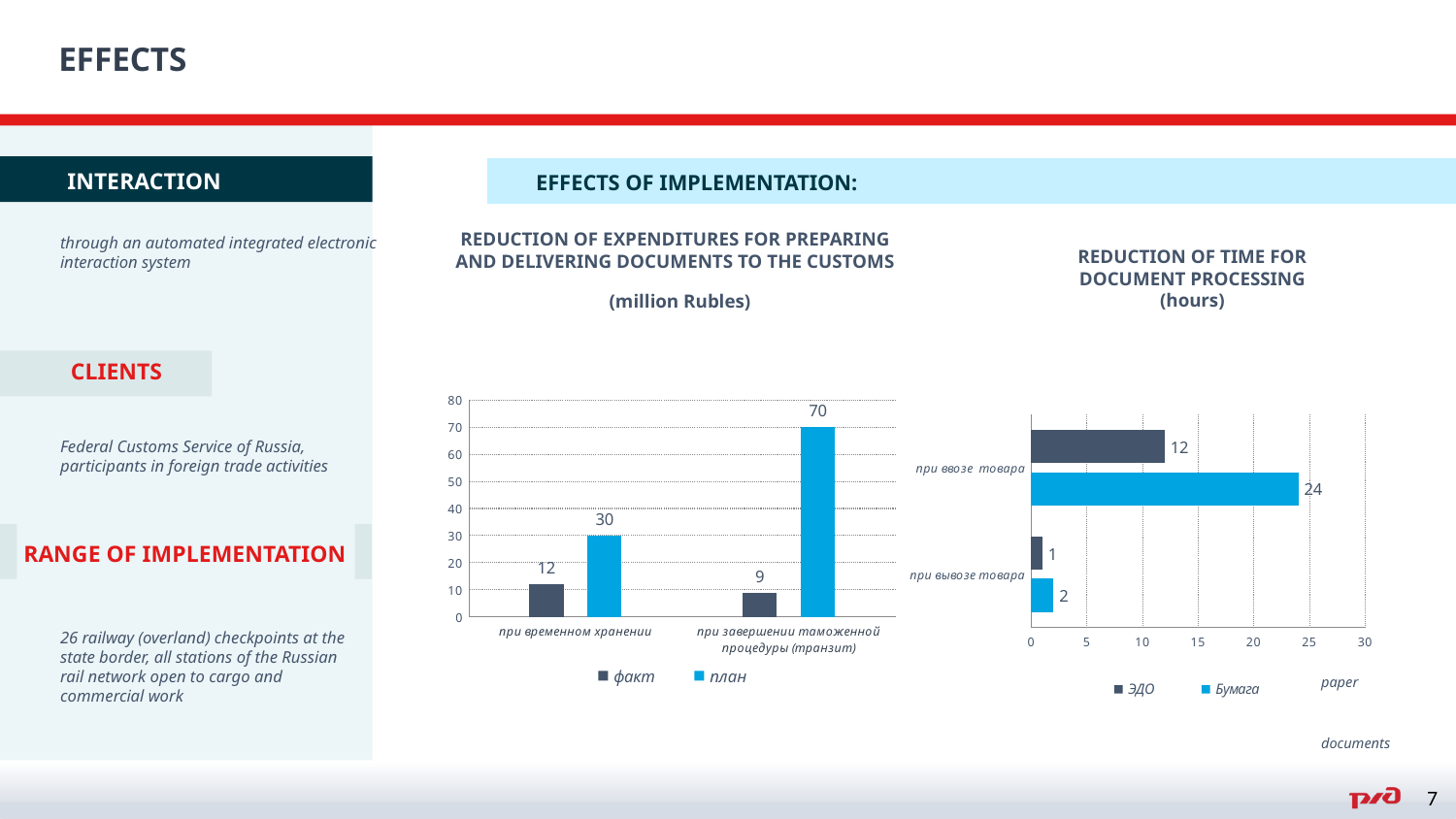
In the 'Reduction of time for document processing' chart, what is the difference between the Бумага and ЭДО values for 'при ввозе товара'? 12 In the 'Reduction of expenditures' chart, what is the факт value for 'при временном хранении'? 12 In the 'Reduction of time for document processing' chart, which is larger for 'при вывозе товара': ЭДО or Бумага? Бумага What kind of chart is the 'Reduction of expenditures' chart? Bar chart What unit is given in the title of the 'Reduction of time for document processing' chart? hours How many categories are shown in the 'Reduction of time for document processing' chart? 2 In the 'Reduction of time for document processing' chart, what is the ЭДО value for 'при вывозе товара'? 1 In the 'Reduction of expenditures' chart, what is the difference between the план and факт values for 'при временном хранении'? 18 In the 'Reduction of expenditures' chart, which category has the lowest факт value? при завершении таможенной процедуры (транзит) In the 'Reduction of expenditures' chart, what is the план value for 'при завершении таможенной процедуры (транзит)'? 70 In the 'Reduction of expenditures' chart, how many series does the legend list? 2 In the 'Reduction of time for document processing' chart, what is the Бумага value for 'при ввозе товара'? 24